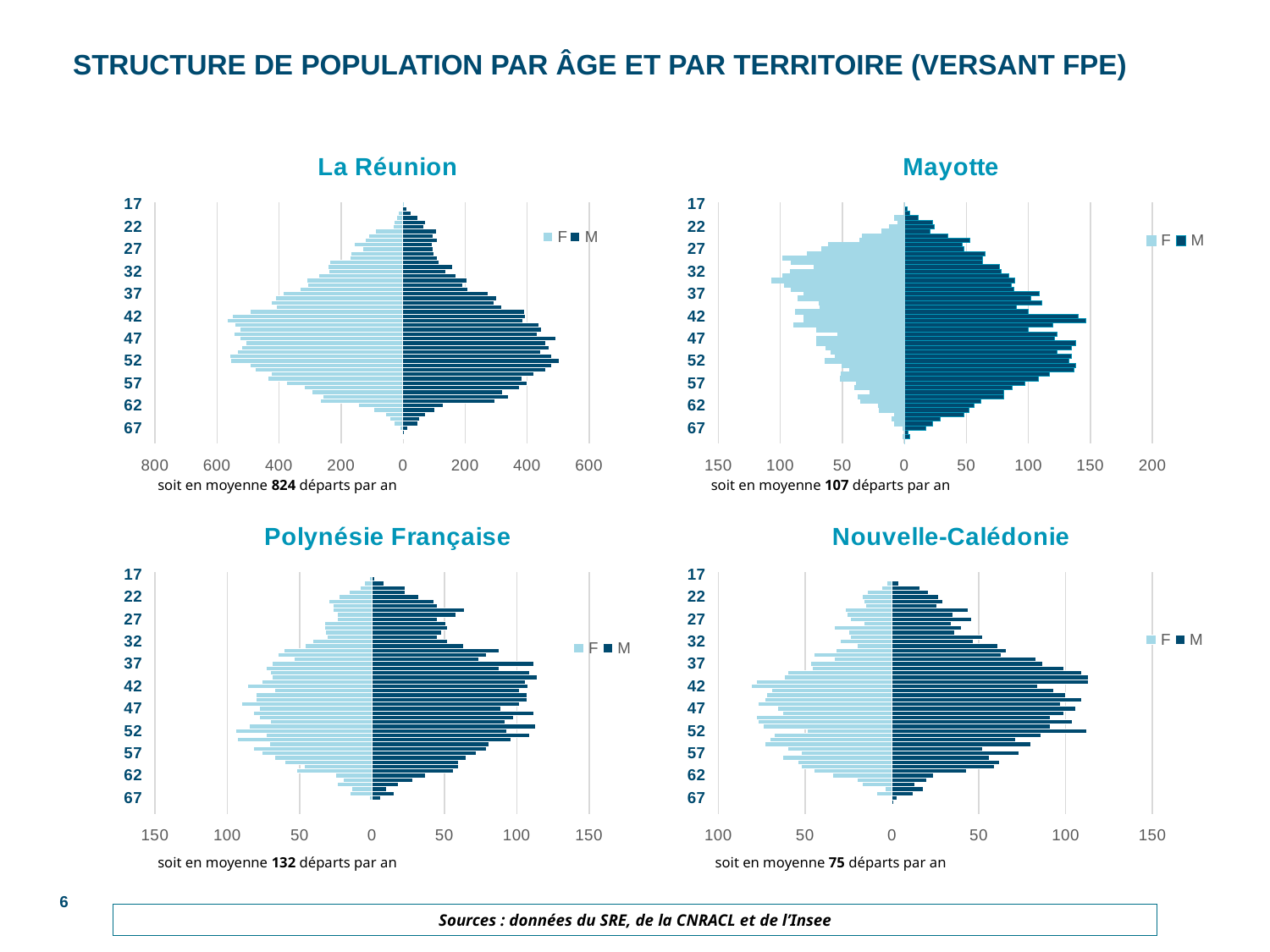
How many series does the legend of the Mayotte chart list? 2 How many age labels are shown on the vertical axis of the Nouvelle-Calédonie chart? 11 What is the title of the top-right chart? Mayotte What kind of chart is used for La Réunion? bar chart In the Mayotte chart, which is larger at age 52, the F value or the M value? M In the Nouvelle-Calédonie chart, is the M value for age 42 greater or less than 50? greater How many charts are shown on the slide? 4 In the Polynésie Française chart, is the F value for age 22 greater or less than 50? less What are the two legend entries on the Polynésie Française chart? F and M In the Mayotte chart, is the M value for age 42 greater or less than 100? greater